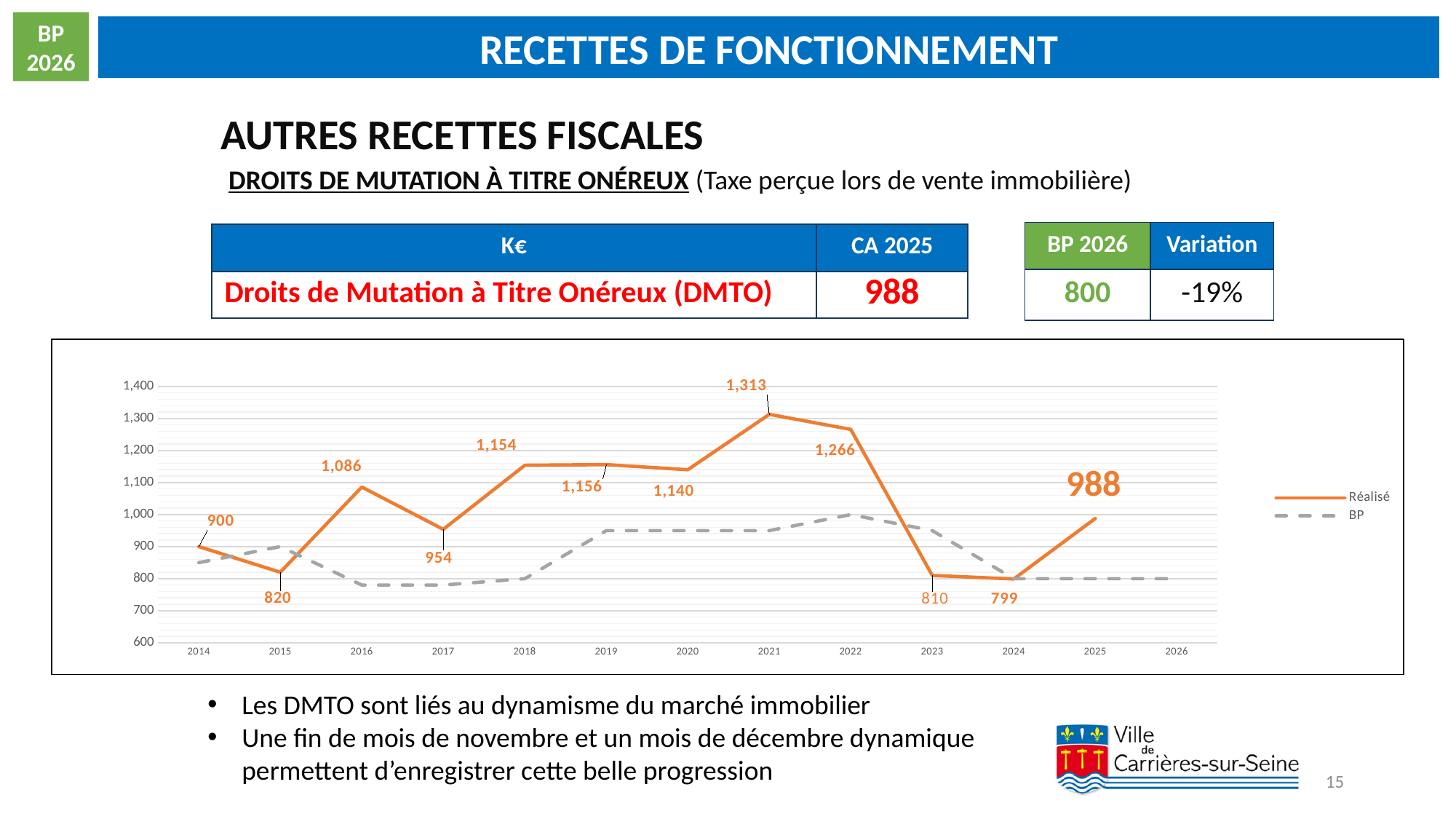
How many series does the chart legend list? 2 How many years are shown on the x axis of the chart? 13 In which year is the Réalisé value lowest? 2024 What is the Réalisé value for 2016? 1,086 What kind of chart is shown on the slide? line chart What is the difference between the Réalisé values for 2021 and 2022? 47 In which year is the Réalisé value highest? 2021 By how much did the Réalisé value increase from 2024 to 2025? 189 Is the BP value for 2016 greater or less than 800? less Does the Réalisé series rise or fall from 2022 to 2024? fall What is the Réalisé value for 2021? 1,313 Which year has the larger Réalisé value, 2018 or 2020? 2018